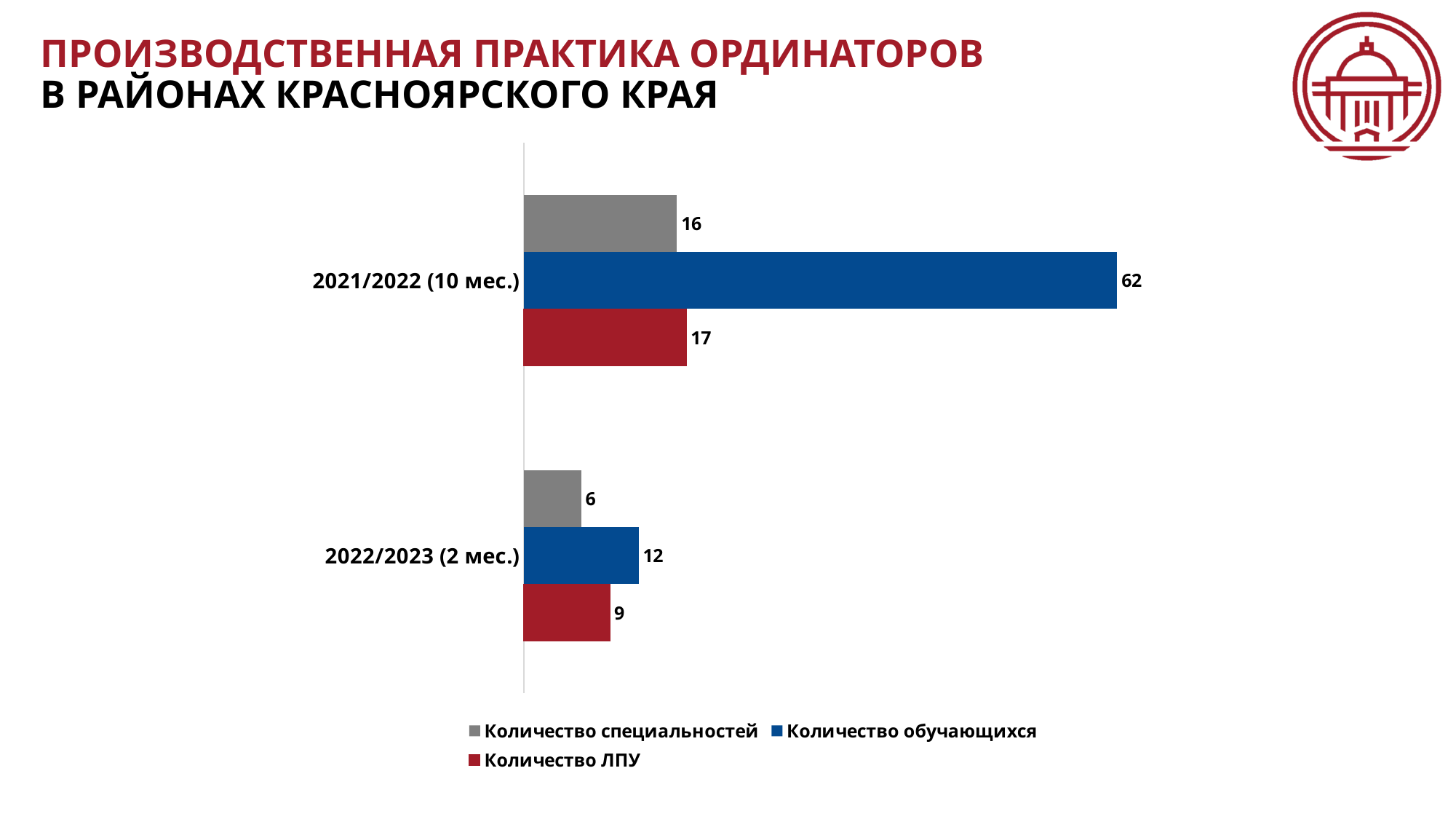
What is the value of Количество обучающихся for 2021/2022 (10 мес.)? 62 Which is larger: Количество ЛПУ for 2022/2023 (2 мес.) or Количество специальностей for 2022/2023 (2 мес.)? Количество ЛПУ How many series does the legend list? 3 What kind of chart is shown on the slide? Bar chart What is the value of Количество обучающихся for 2022/2023 (2 мес.)? 12 What is the value of Количество специальностей for 2021/2022 (10 мес.)? 16 What is the value of Количество ЛПУ for 2022/2023 (2 мес.)? 9 What is the difference between Количество ЛПУ and Количество специальностей for 2021/2022 (10 мес.)? 1 Which category has the highest value for Количество обучающихся? 2021/2022 (10 мес.) How many categories are shown on the chart? 2 Which series has the lowest value for 2022/2023 (2 мес.)? Количество специальностей What is the difference between Количество обучающихся for 2021/2022 (10 мес.) and 2022/2023 (2 мес.)? 50